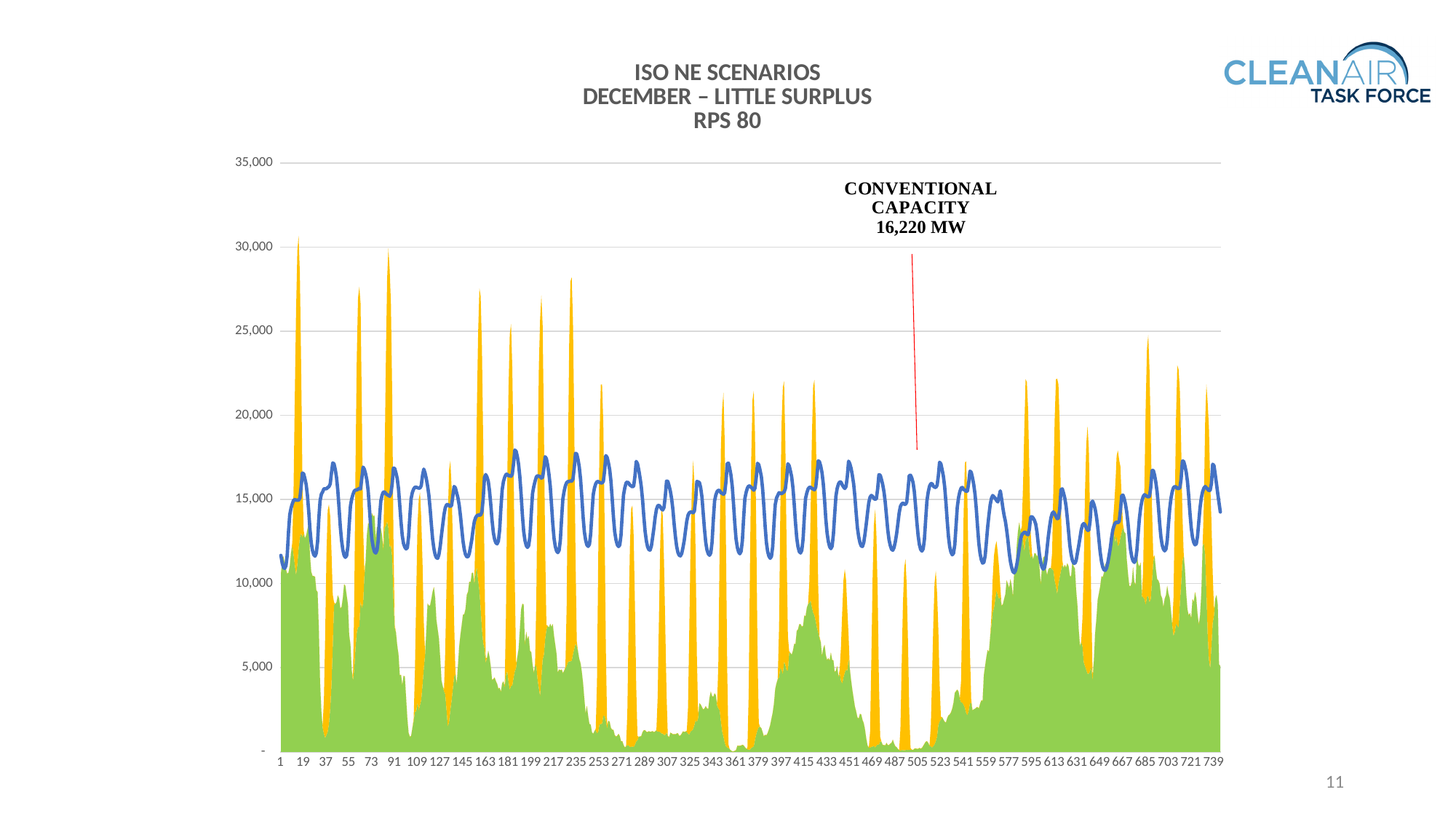
What is the last label on the horizontal axis? 739 How many distinct coloured series are plotted on the chart (excluding the red annotation line)? 3 What is the title of the chart? ISO NE SCENARIOS DECEMBER – LITTLE SURPLUS RPS 80 What is the first label on the horizontal axis? 1 Is the value of the blue line at hour 1 greater or less than 15,000? less Is the value of the green series at hour 1 greater or less than 15,000? less What is the highest value shown on the vertical axis? 35,000 Which is larger: the yellow peak near hour 19 or the yellow peak near hour 685? the peak near hour 19 Is the peak of the yellow series near hour 19 greater or less than 25,000? greater What conventional capacity value is annotated on the chart? 16,220 MW